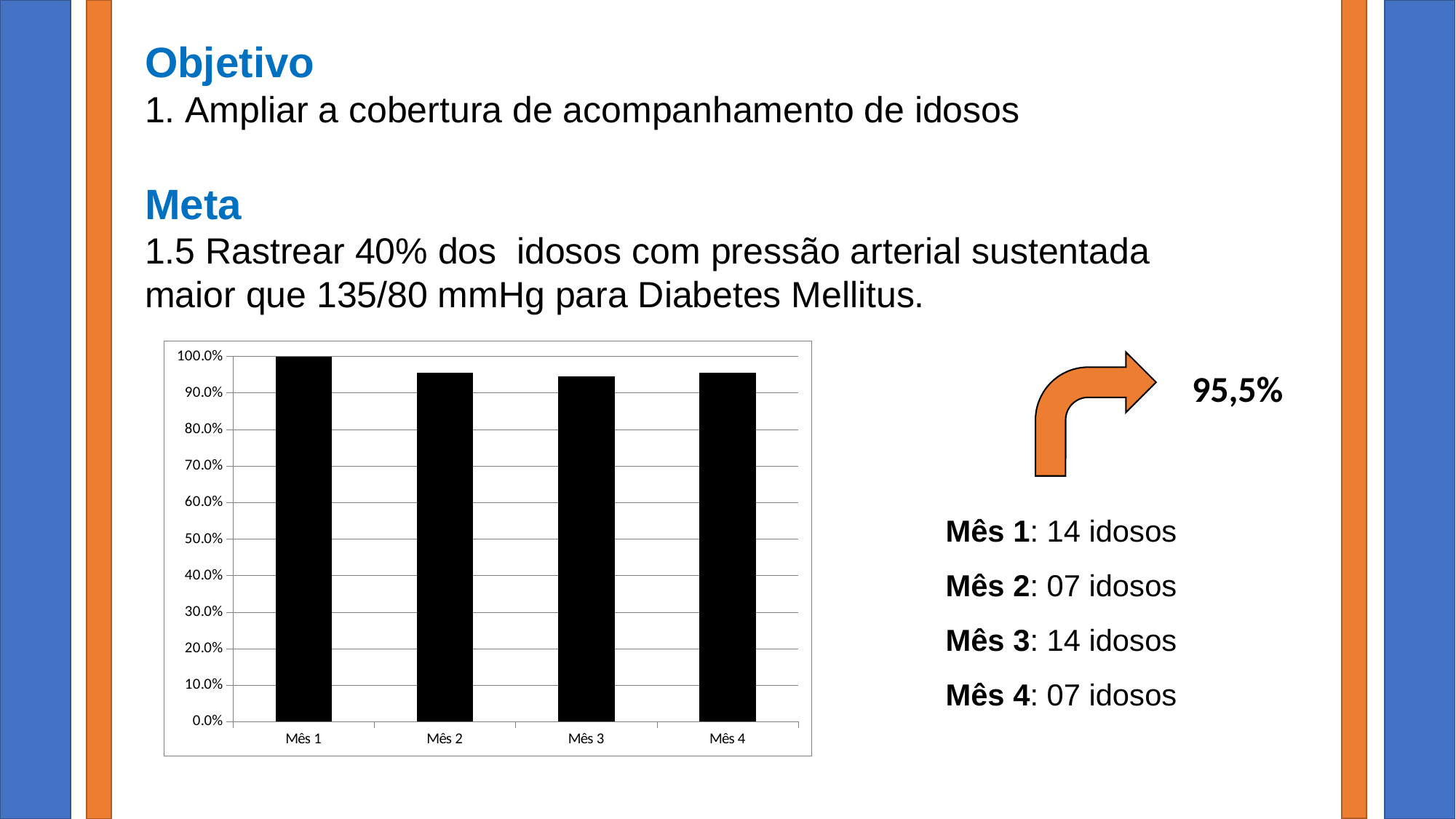
Which is larger on the chart, the value for Mês 1 or the value for Mês 2? Mês 1 What kind of chart is shown on the slide? bar chart What is the value for Mês 1 on the chart? 100.0% What is the highest value shown on the chart's vertical axis? 100.0% Is the value for Mês 3 greater or less than 90.0%? greater Does the value rise or fall from Mês 1 to Mês 2? fall Is the value for Mês 2 greater or less than 90.0%? greater Which is larger on the chart, the value for Mês 1 or the value for Mês 3? Mês 1 Which month has the highest value on the chart? Mês 1 Is the value for Mês 4 greater or less than 80.0%? greater How many categories (months) are plotted on the chart? 4 What colour are the bars on the chart? black